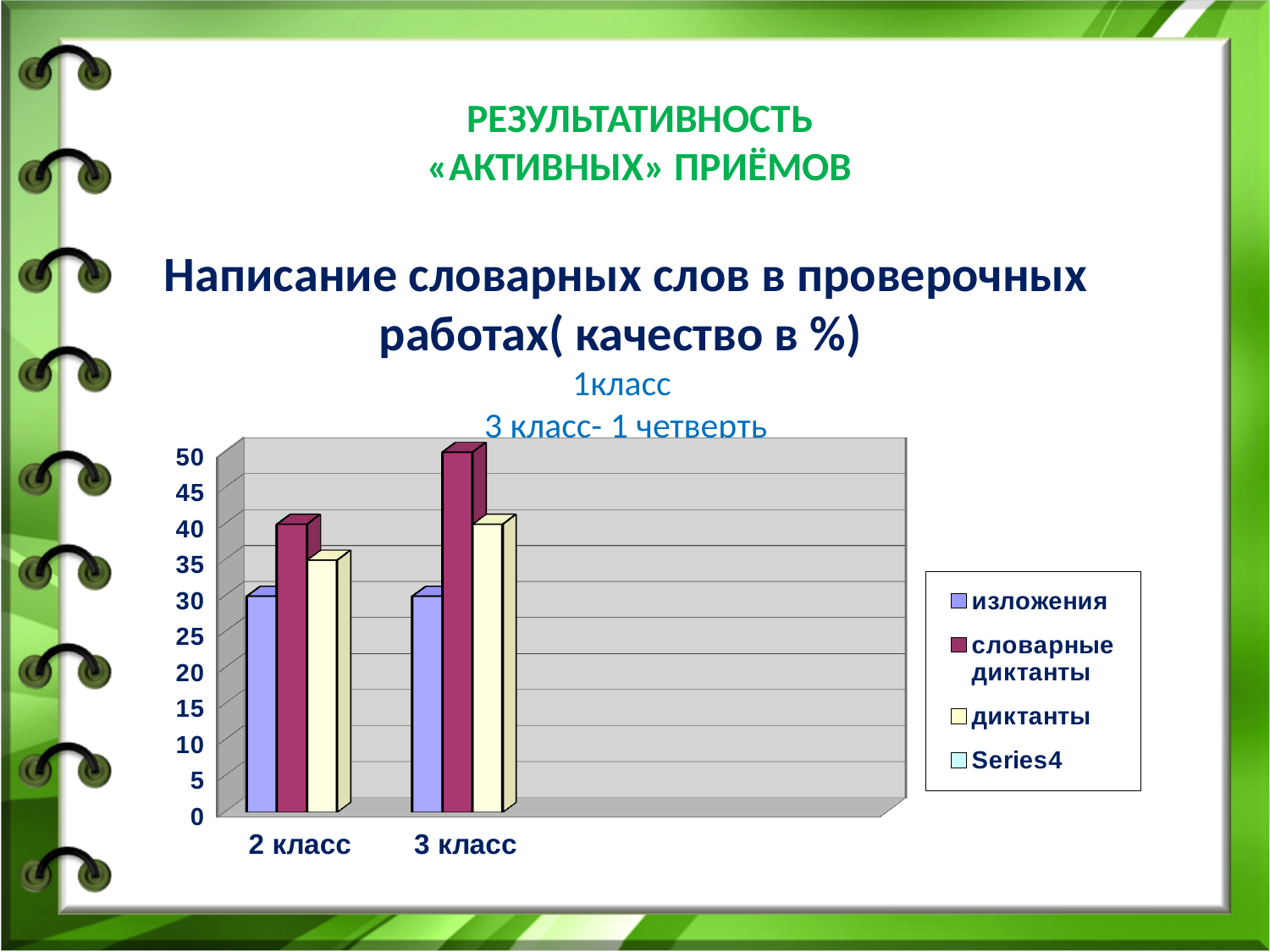
Is the value for диктанты in 2 класс greater or less than 40? less What is the value for изложения in 2 класс? 30 Is the value for словарные диктанты in 2 класс greater or less than 35? greater Does the value for словарные диктанты rise or fall from 2 класс to 3 класс? rise Which series has the lowest value in 2 класс? изложения How many series does the chart legend list? 4 Which is larger: словарные диктанты in 2 класс or словарные диктанты in 3 класс? 3 класс What kind of chart is shown on the slide? bar chart What is the value for словарные диктанты in 3 класс? 50 What is the value for диктанты in 3 класс? 40 How many categories are shown on the x axis of the chart? 2 Which series has the highest value in 3 класс? словарные диктанты